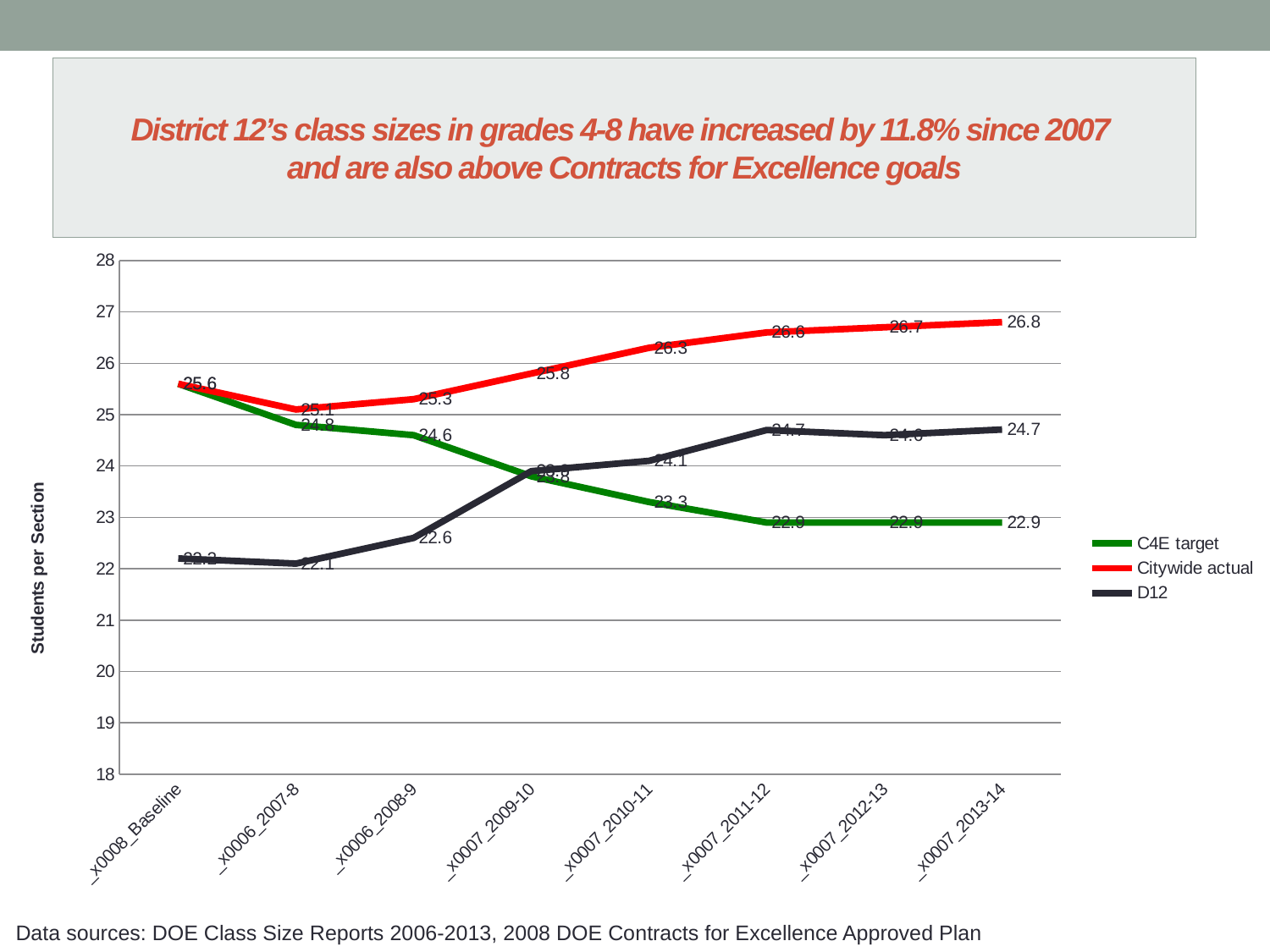
What is the difference between the Citywide actual and D12 values for 2013-14? 2.1 What type of chart is shown on the slide? line chart How many series does the legend list? 3 What is the C4E target value for 2013-14? 22.9 What is the title of the y axis? Students per Section Which series has the highest value at 2013-14? Citywide actual Is the D12 value at Baseline greater or less than 23? less How many points are plotted along the x axis for each series? 8 What is the D12 value for 2013-14? 24.7 What is the Citywide actual value for 2013-14? 26.8 What is the Citywide actual value for 2010-11? 26.3 Does the C4E target line rise or fall from Baseline to 2013-14? fall